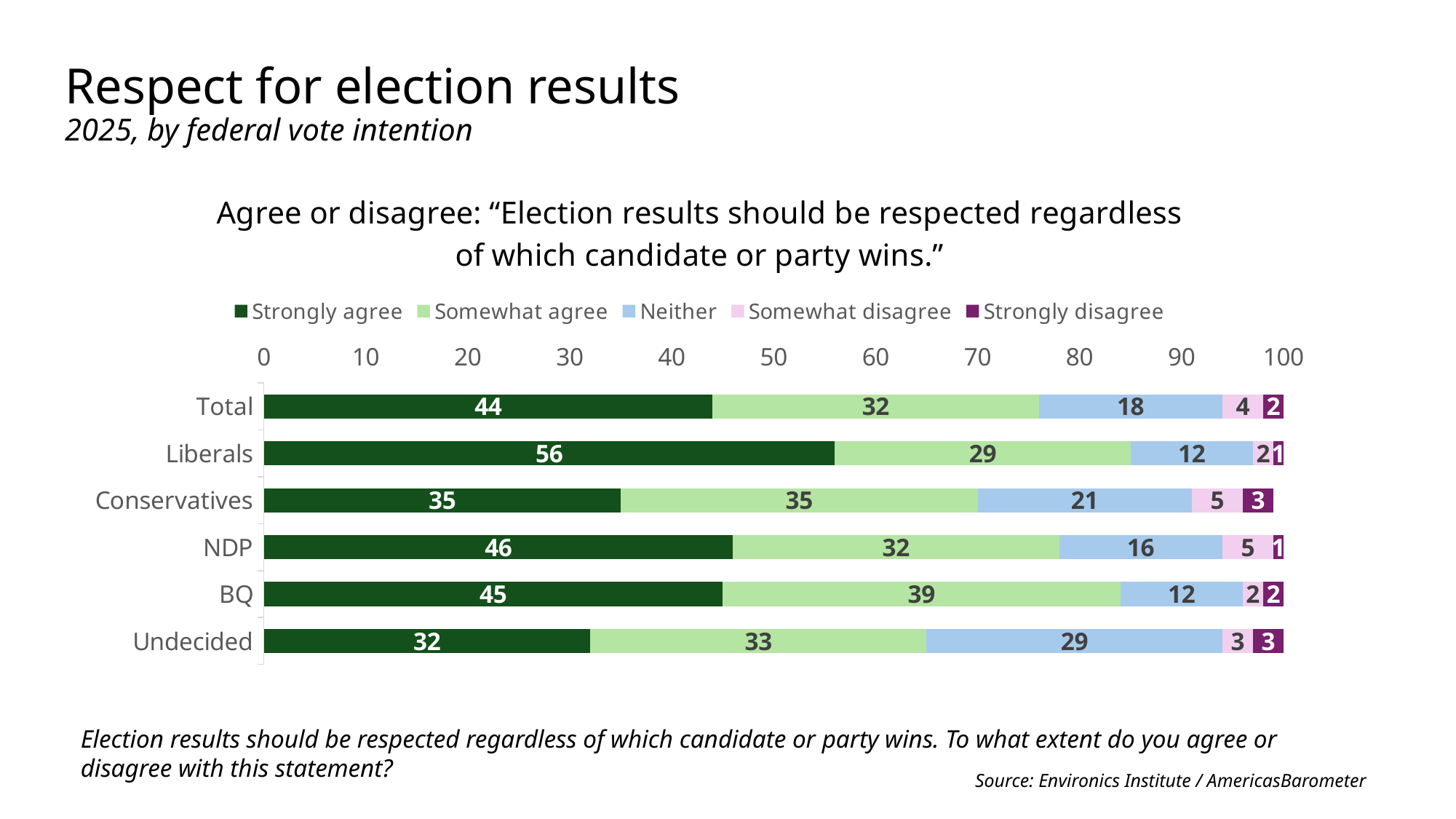
What kind of chart is shown on the slide? Stacked bar chart Which vote-intention group has the highest 'Strongly agree' value? Liberals What is the total of the Conservatives bar across all five response categories? 99 What is the 'Neither' value for Undecided voters? 29 What is the difference between the 'Strongly agree' values for Liberals and Conservatives? 21 How many vote-intention groups (bars) are shown in the chart? 6 How many response categories does the legend list? 5 What is the 'Somewhat agree' value for BQ voters? 39 Which is larger: the 'Neither' value for Conservatives or for NDP? Conservatives Which vote-intention group has the lowest 'Strongly agree' value? Undecided What percentage of Liberals strongly agree that election results should be respected regardless of which candidate or party wins? 56 Which response category is shown in the darkest green colour? Strongly agree